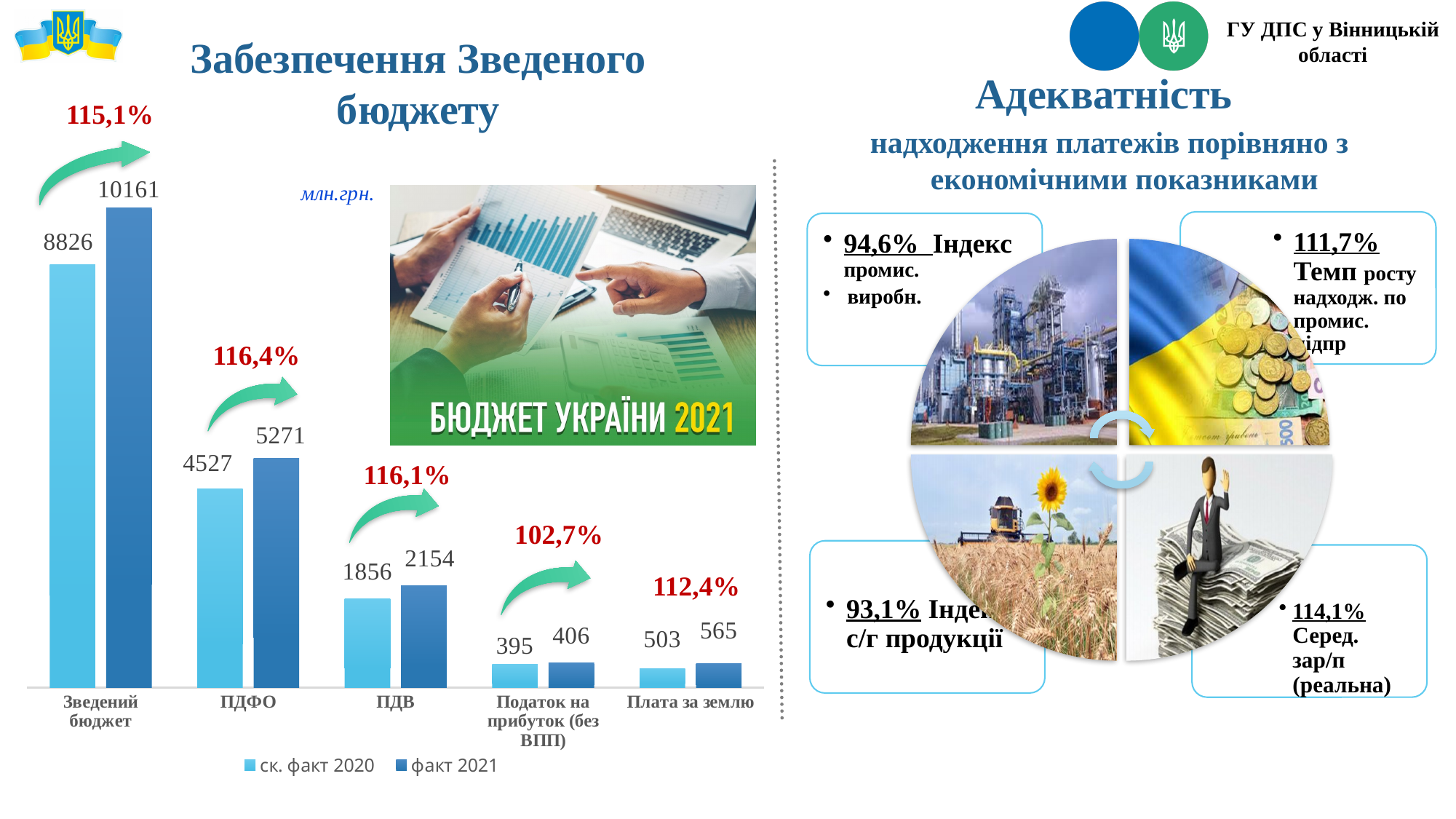
What type of chart is shown on the left of the slide? bar chart What is the value for Зведений бюджет in the ск. факт 2020 series? 8826 Which category has the lowest value in the ск. факт 2020 series? Податок на прибуток (без ВПП) Which is larger: the факт 2021 value for Плата за землю or the факт 2021 value for Податок на прибуток (без ВПП)? Плата за землю How many categories are shown on the x axis of the bar chart? 5 What is the difference between the факт 2021 and ск. факт 2020 values for ПДФО? 744 What is the value for ПДВ in the ск. факт 2020 series? 1856 Which category has the highest value in the факт 2021 series? Зведений бюджет What is the value for Плата за землю in the факт 2021 series? 565 What is the difference between the факт 2021 and ск. факт 2020 values for Зведений бюджет? 1335 What is the value for ПДФО in the факт 2021 series? 5271 How many series does the legend of the bar chart list? 2